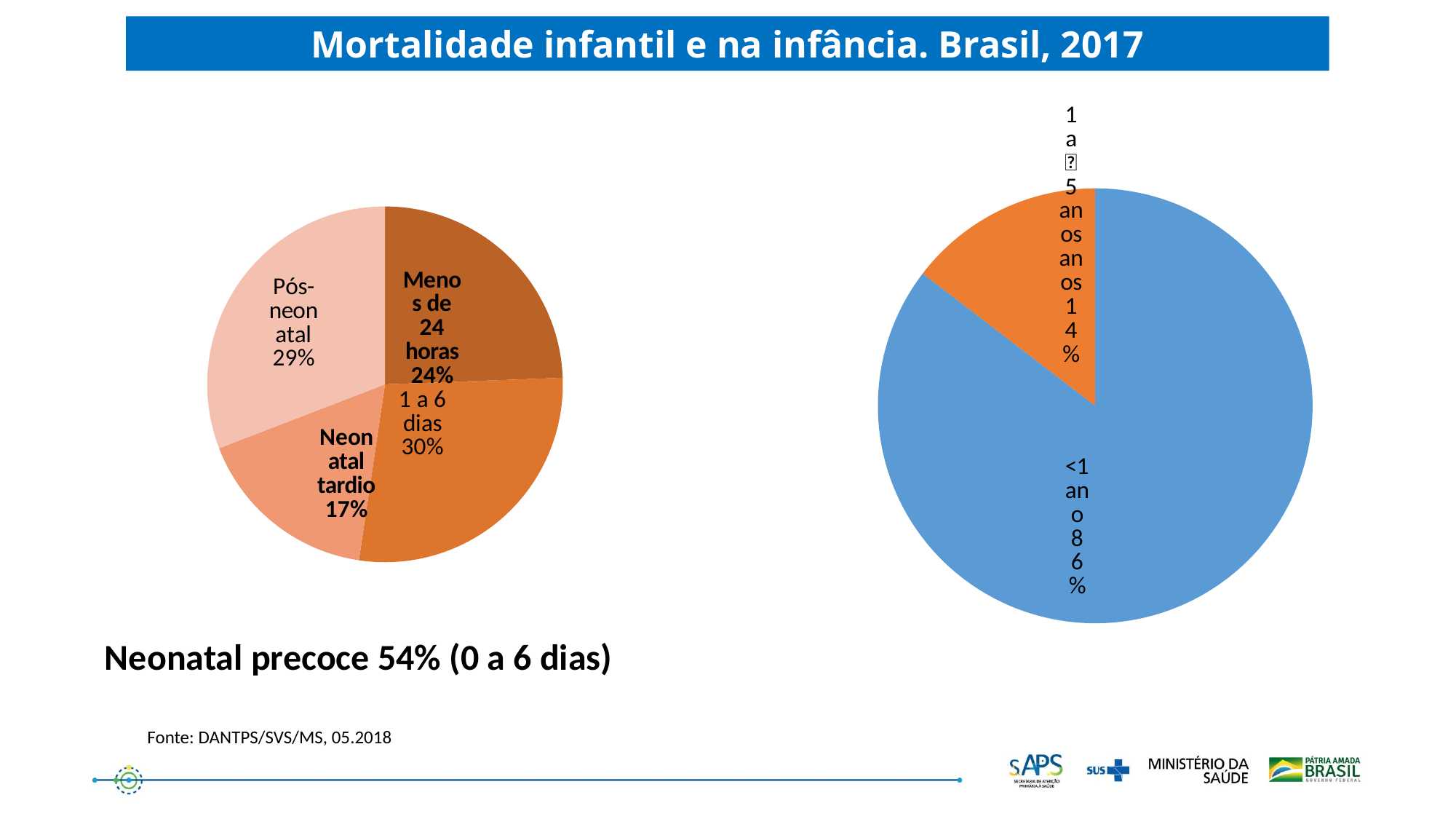
In the left pie chart, which slice is the smallest? Neonatal tardio In the left pie chart, what share is labelled for 'Pós-neonatal'? 29% In the right pie chart, which slice is larger: '<1 ano' or '1 a 5 anos'? <1 ano In the left pie chart, what is the difference between the 'Pós-neonatal' share and the 'Neonatal tardio' share? 12% In the left pie chart, what share is labelled for 'Neonatal tardio'? 17% In the right pie chart, what share is labelled for '<1 ano'? 86% In the left pie chart, what share is labelled for 'Menos de 24 horas'? 24% What type of chart is the left chart on the slide? Pie chart In the left pie chart, what share is labelled for '1 a 6 dias'? 30% In the left pie chart, how many slices are there? 4 What is the title of the slide containing the two pie charts? Mortalidade infantil e na infância. Brasil, 2017